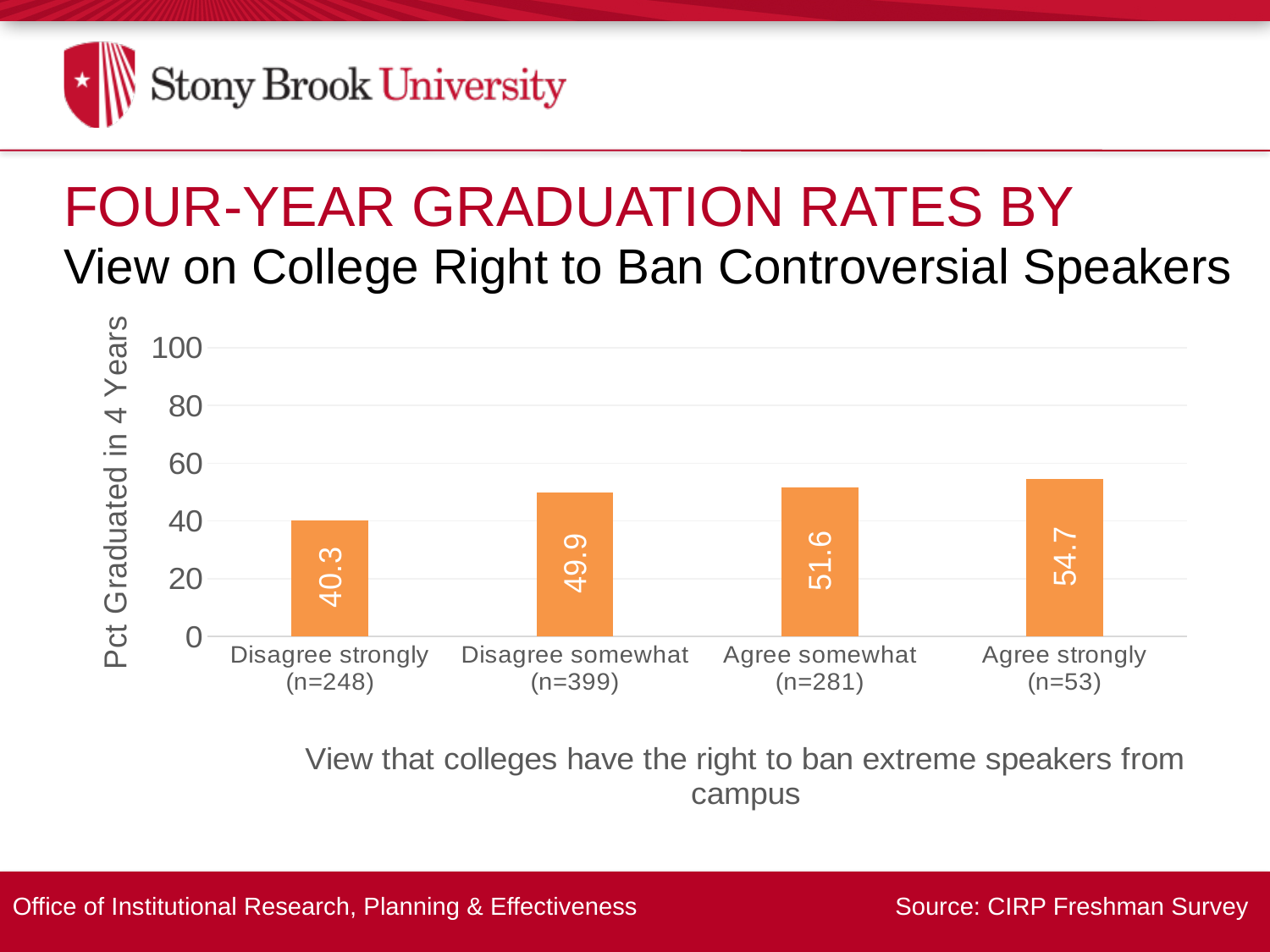
Which response group has the lowest four-year graduation rate? Disagree strongly How many response categories are shown on the x axis? 4 Do the four-year graduation rates rise or fall moving from 'Disagree strongly' to 'Agree strongly' along the x axis? Rise What kind of chart is shown on the slide? Bar chart Which response group has the highest four-year graduation rate? Agree strongly Is the four-year graduation rate for the 'Agree strongly' group greater or less than 60? less What is the sample size (n) for the 'Agree strongly' group? 53 Which group has a higher four-year graduation rate, 'Agree somewhat' or 'Disagree somewhat'? Agree somewhat What is the four-year graduation rate for the 'Disagree somewhat' group? 49.9 What is the four-year graduation rate for students who disagree strongly that colleges have the right to ban extreme speakers? 40.3 What is the four-year graduation rate for the 'Agree somewhat' group? 51.6 What is the difference in four-year graduation rate between the 'Agree strongly' and 'Disagree strongly' groups? 14.4